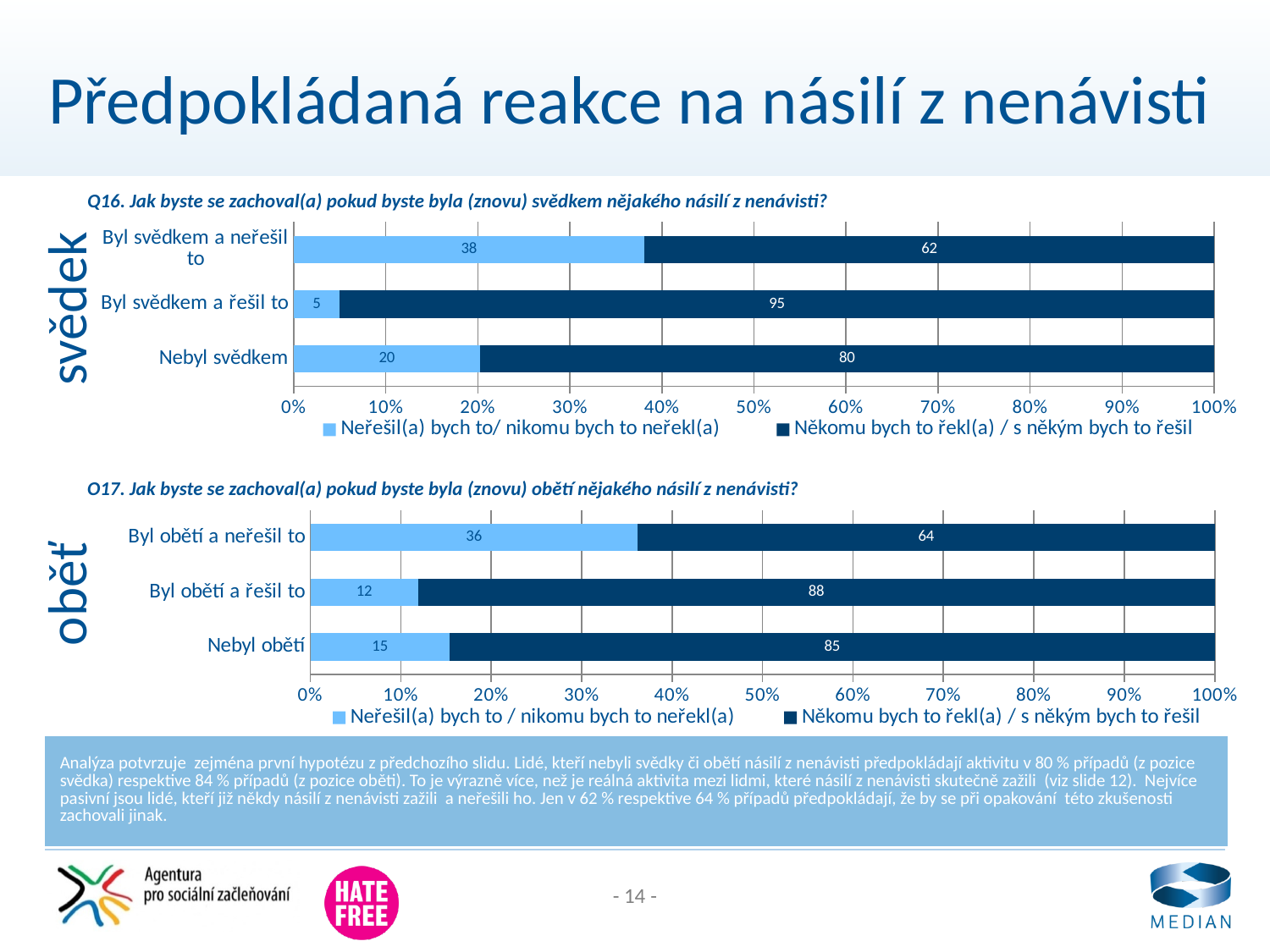
In the top chart (Q16, svědek), what is the value for 'Neřešil(a) bych to/ nikomu bych to neřekl(a)' in the 'Byl svědkem a neřešil to' category? 38 In the top chart (Q16, svědek), which category has the highest value for 'Neřešil(a) bych to/ nikomu bych to neřekl(a)'? Byl svědkem a neřešil to In the bottom chart (O17, oběť), what is the value for 'Neřešil(a) bych to / nikomu bych to neřekl(a)' in the 'Byl obětí a řešil to' category? 12 In the top chart (Q16, svědek), how many categories are shown on the vertical axis? 3 In the bottom chart (O17, oběť), which category has the highest value for 'Někomu bych to řekl(a) / s někým bych to řešil'? Byl obětí a řešil to What type of chart is the top chart (Q16, svědek)? Stacked bar chart In the bottom chart (O17, oběť), how many series does the legend list? 2 In the top chart (Q16, svědek), what is the difference between the 'Někomu bych to řekl(a) / s někým bych to řešil' values for 'Nebyl svědkem' and 'Byl svědkem a neřešil to'? 18 In the bottom chart (O17, oběť), what is the value for 'Někomu bych to řekl(a) / s někým bych to řešil' in the 'Nebyl obětí' category? 85 In the top chart (Q16, svědek), which category has the lowest value for 'Neřešil(a) bych to/ nikomu bych to neřekl(a)'? Byl svědkem a řešil to In the bottom chart (O17, oběť), is the 'Neřešil(a) bych to / nikomu bych to neřekl(a)' value larger for 'Byl obětí a neřešil to' or for 'Nebyl obětí'? Byl obětí a neřešil to In the top chart (Q16, svědek), what is the value for 'Někomu bych to řekl(a) / s někým bych to řešil' in the 'Byl svědkem a řešil to' category? 95